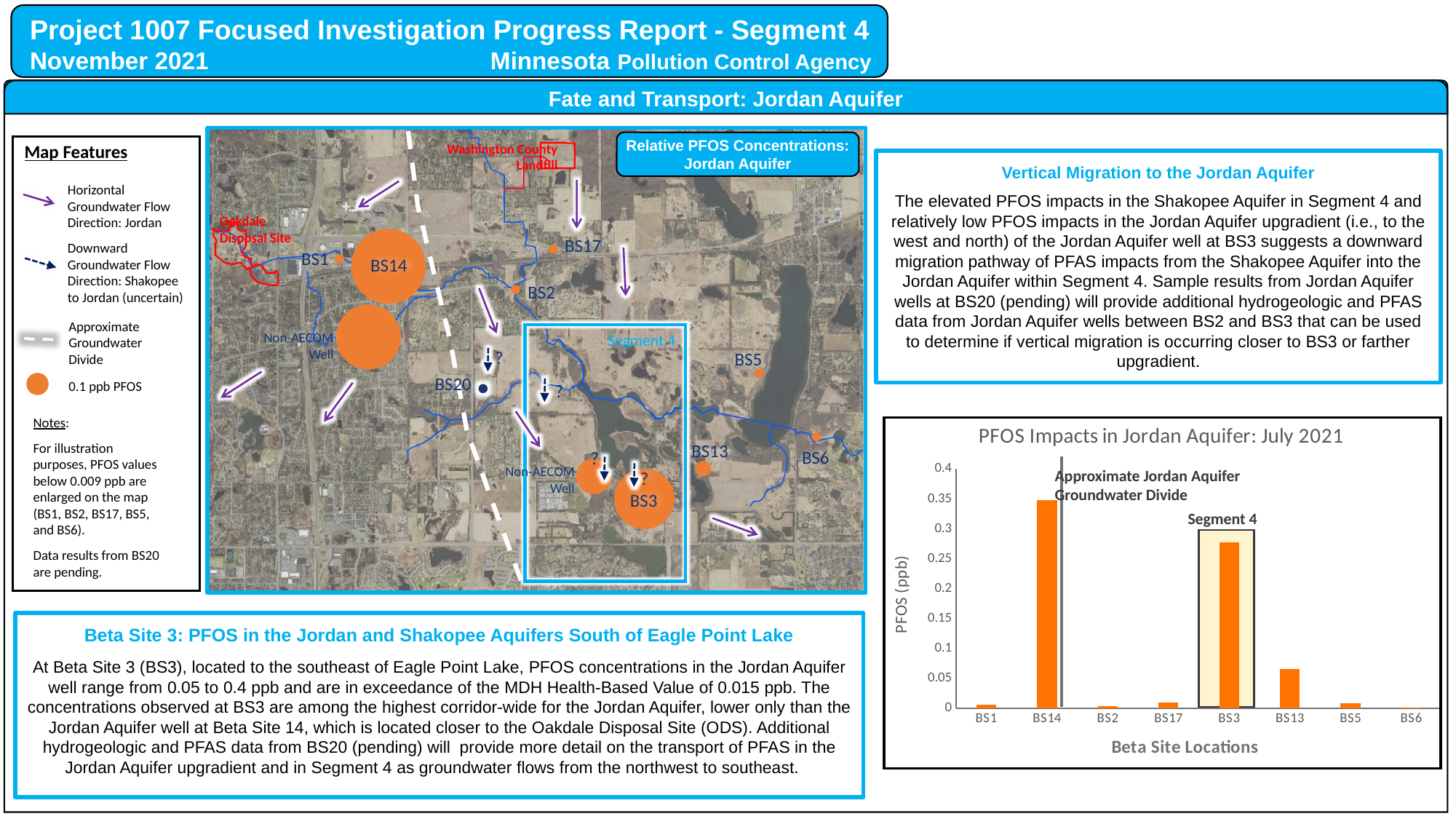
In the PFOS Impacts in Jordan Aquifer chart, which is larger, the value for BS3 or the value for BS13? BS3 In the PFOS Impacts in Jordan Aquifer chart, which is larger, the value for BS14 or the value for BS3? BS14 How many beta site locations are shown on the x axis of the PFOS Impacts in Jordan Aquifer chart? 8 In the PFOS Impacts in Jordan Aquifer chart, is the value for BS3 greater or less than 0.25? greater In the PFOS Impacts in Jordan Aquifer chart, is the value for BS13 greater or less than 0.05? greater In the PFOS Impacts in Jordan Aquifer chart, is the value for BS14 greater or less than 0.3? greater What is the y-axis label of the PFOS Impacts in Jordan Aquifer chart? PFOS (ppb) What is the title of the bar chart on the slide? PFOS Impacts in Jordan Aquifer: July 2021 Which beta site has the highest PFOS value in the PFOS Impacts in Jordan Aquifer chart? BS14 What kind of chart is "PFOS Impacts in Jordan Aquifer: July 2021"? bar chart